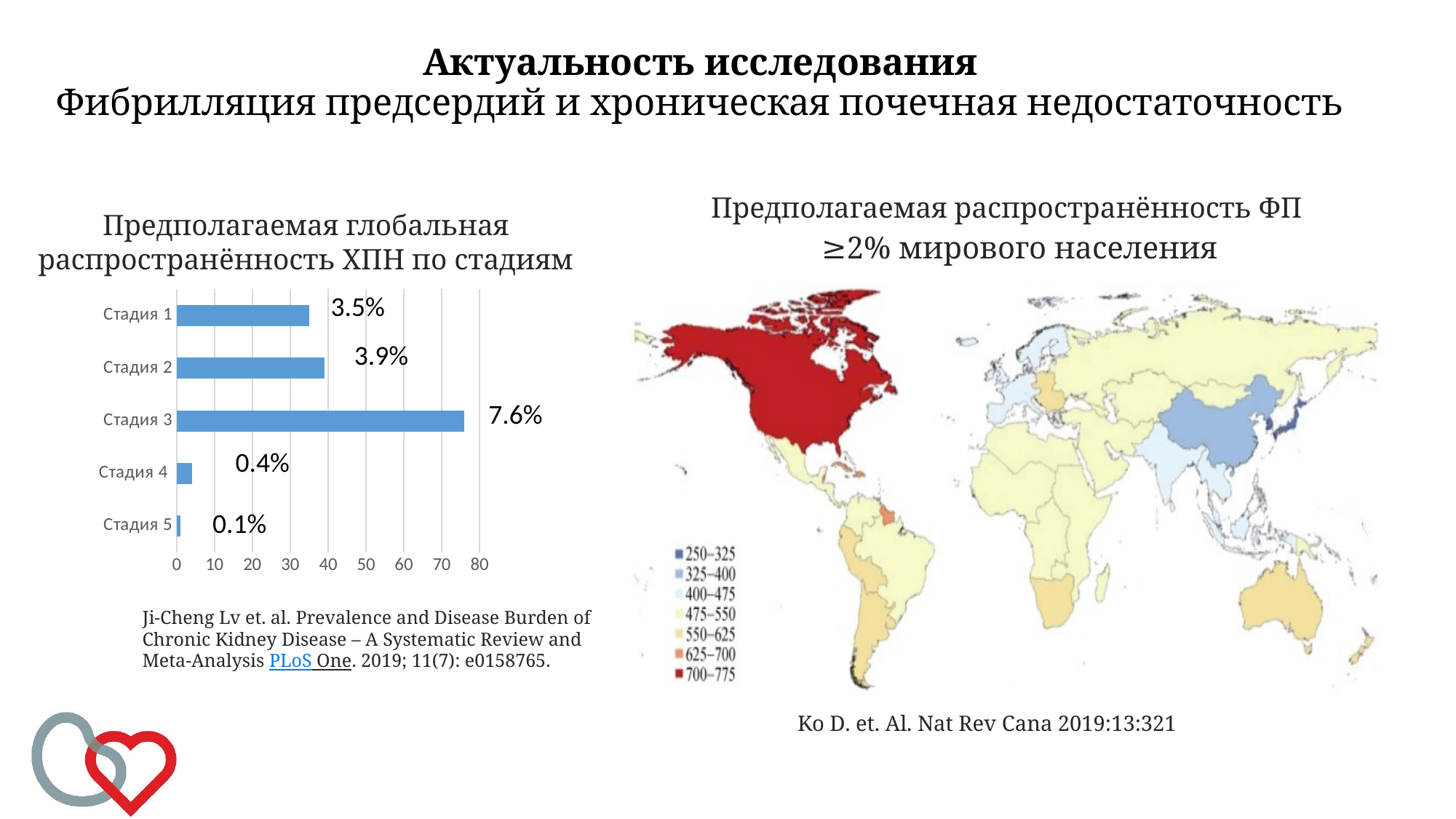
In the bar chart 'Предполагаемая глобальная распространённость ХПН по стадиям', which stage has the highest value? Стадия 3 In the bar chart 'Предполагаемая глобальная распространённость ХПН по стадиям', which is larger, the value for Стадия 2 or Стадия 4? Стадия 2 How many stages (categories) are shown in the bar chart 'Предполагаемая глобальная распространённость ХПН по стадиям'? 5 In the bar chart 'Предполагаемая глобальная распространённость ХПН по стадиям', what is the value for Стадия 4? 0.4% In the bar chart 'Предполагаемая глобальная распространённость ХПН по стадиям', which stage has the lowest value? Стадия 5 In the bar chart 'Предполагаемая глобальная распространённость ХПН по стадиям', what is the value for Стадия 5? 0.1% In the bar chart 'Предполагаемая глобальная распространённость ХПН по стадиям', what is the difference between the values for Стадия 2 and Стадия 1? 0.4% In the bar chart 'Предполагаемая глобальная распространённость ХПН по стадиям', what is the value for Стадия 3? 7.6% In the bar chart 'Предполагаемая глобальная распространённость ХПН по стадиям', what is the difference between the values for Стадия 3 and Стадия 2? 3.7% What is the highest tick value on the horizontal axis of the bar chart 'Предполагаемая глобальная распространённость ХПН по стадиям'? 80 In the bar chart 'Предполагаемая глобальная распространённость ХПН по стадиям', what is the value for Стадия 1? 3.5% What kind of chart is the left chart 'Предполагаемая глобальная распространённость ХПН по стадиям'? Bar chart